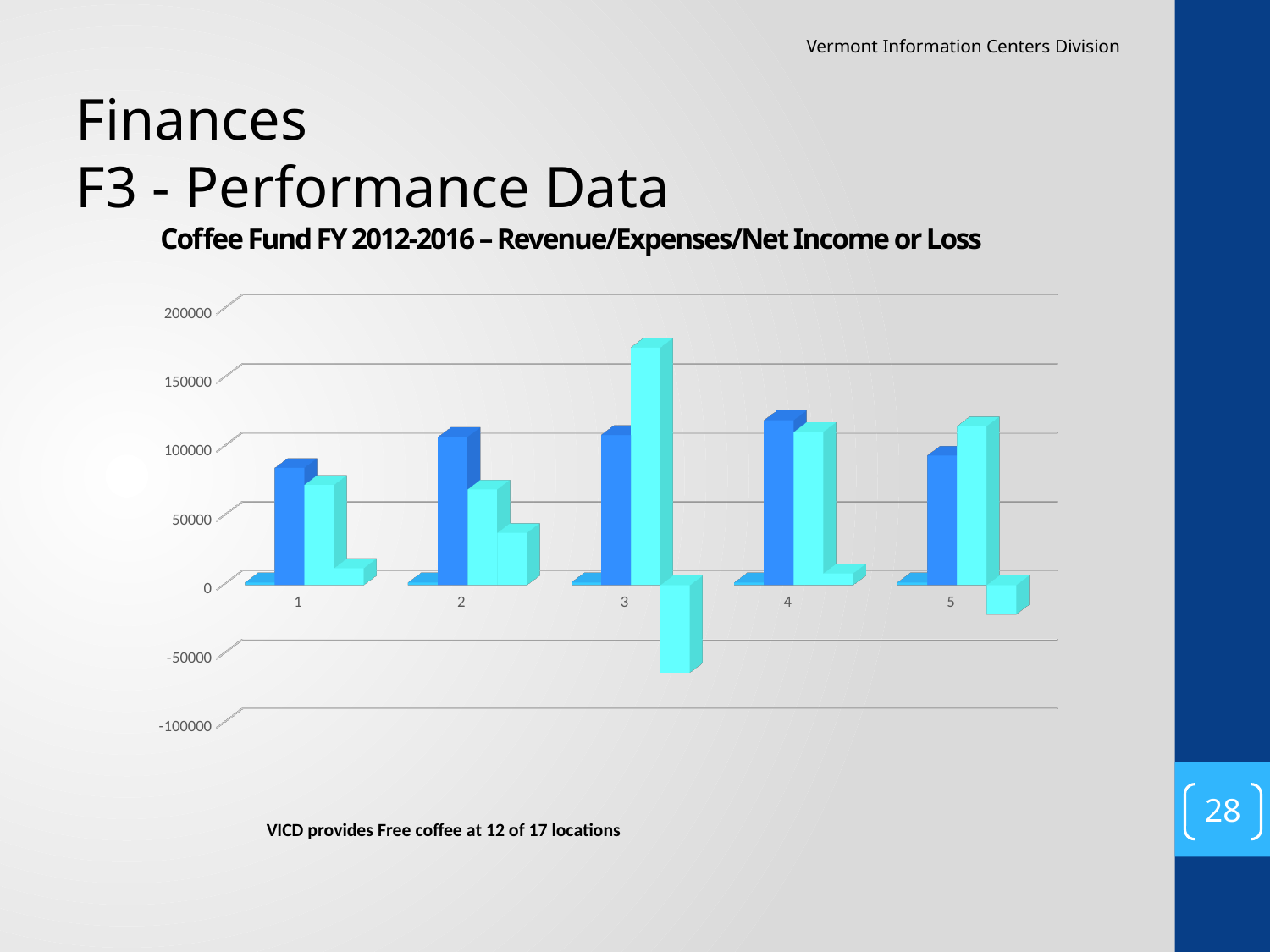
Which category contains the tallest bar on the chart? 3 Is the value of the negative bar in category 3 greater or less than -50000? less How many bars are plotted for each category on the chart? 4 Is the value of the first (dark blue) bar in category 4 greater or less than 100000? greater What is the title of the chart? Coffee Fund FY 2012-2016 – Revenue/Expenses/Net Income or Loss Is the value of the tallest bar in category 3 greater or less than 150000? greater What kind of chart is shown on the slide? bar chart How many categories are shown along the x axis of the chart? 5 Which is larger: the second (cyan) bar in category 3 or the second (cyan) bar in category 1? category 3 Which category contains the lowest (most negative) bar on the chart? 3